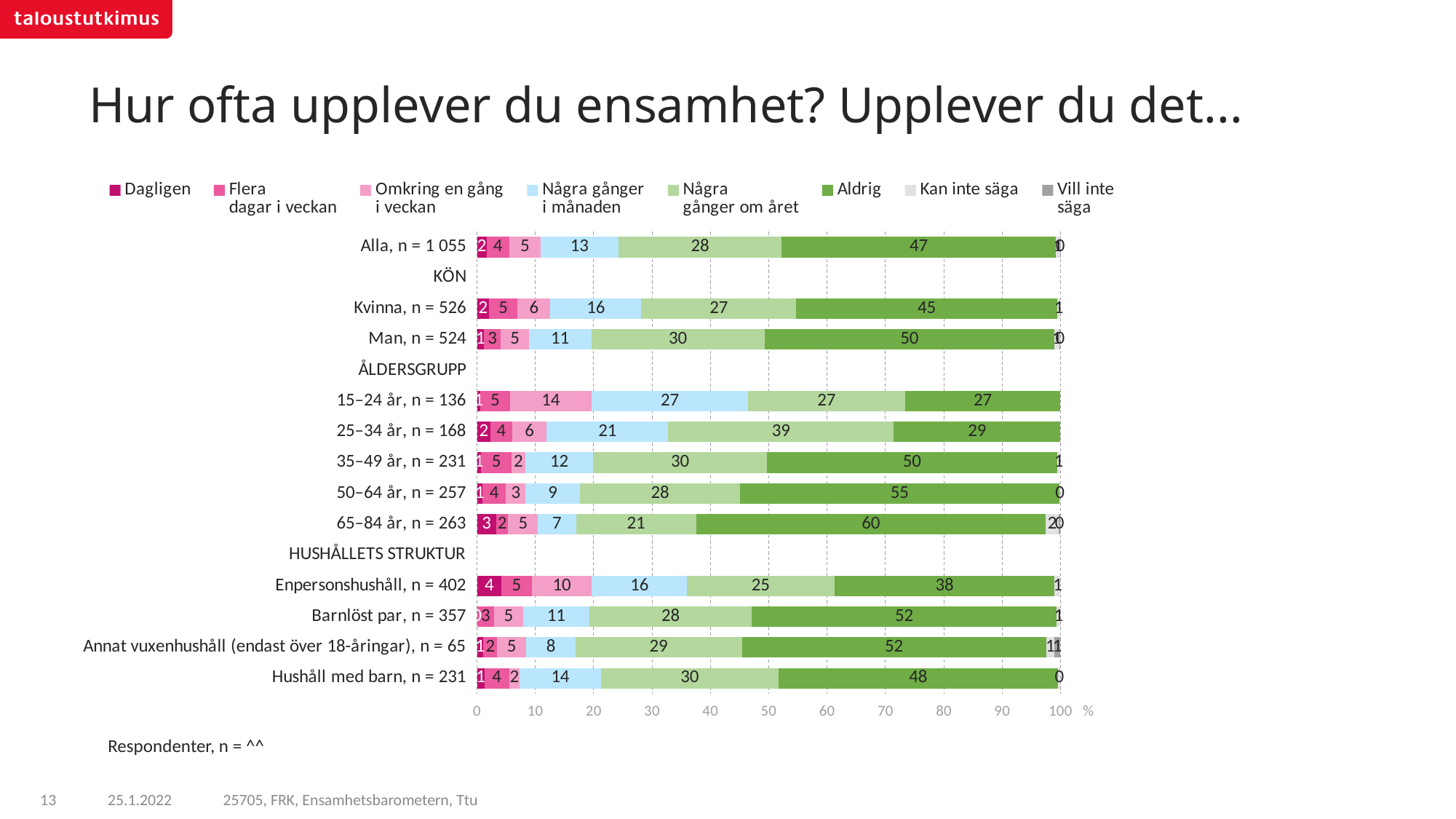
Which group has the highest value for 'Aldrig'? 65–84 år, n = 263 How many respondent groups (bars) are plotted in the chart? 12 What is the title of the slide? Hur ofta upplever du ensamhet? Upplever du det… What is the difference between the 'Aldrig' values for 'Man, n = 524' and 'Kvinna, n = 526'? 5 Which has a larger 'Några gånger om året' value: '25–34 år, n = 168' or '15–24 år, n = 136'? 25–34 år, n = 168 What is the value of 'Dagligen' for 'Enpersonshushåll, n = 402'? 4 What is the value of 'Aldrig' for the group '65–84 år, n = 263'? 60 What is the value of 'Några gånger i månaden' for '15–24 år, n = 136'? 27 What is the value of 'Några gånger om året' for 'Alla, n = 1 055'? 28 How many series does the legend list? 8 Which group has the lowest value for 'Aldrig'? 15–24 år, n = 136 What kind of chart is shown on the slide? Stacked bar chart